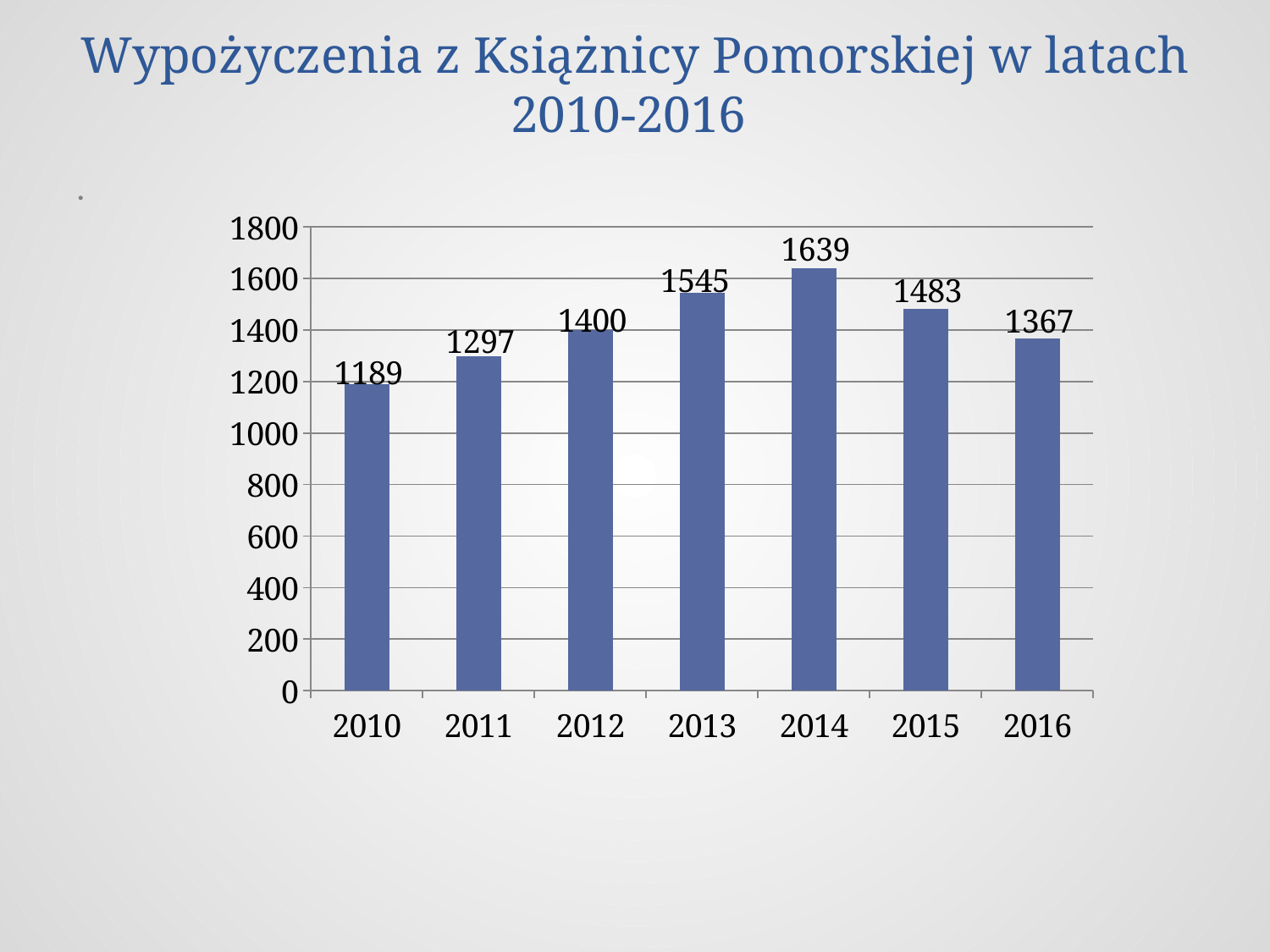
Is the value for 2013 greater or less than 1400? greater What is the difference between the values for 2012 and 2010? 211 How many years are shown on the x axis? 7 What is the value for 2016? 1367 Do the values rise or fall from 2014 to 2016? fall What is the value for 2010? 1189 Which year has the lowest value? 2010 What is the value for 2014? 1639 What kind of chart is shown on the slide? bar chart Which year has the highest value? 2014 Which is larger, the value for 2015 or the value for 2016? 2015 What is the difference between the values for 2014 and 2013? 94